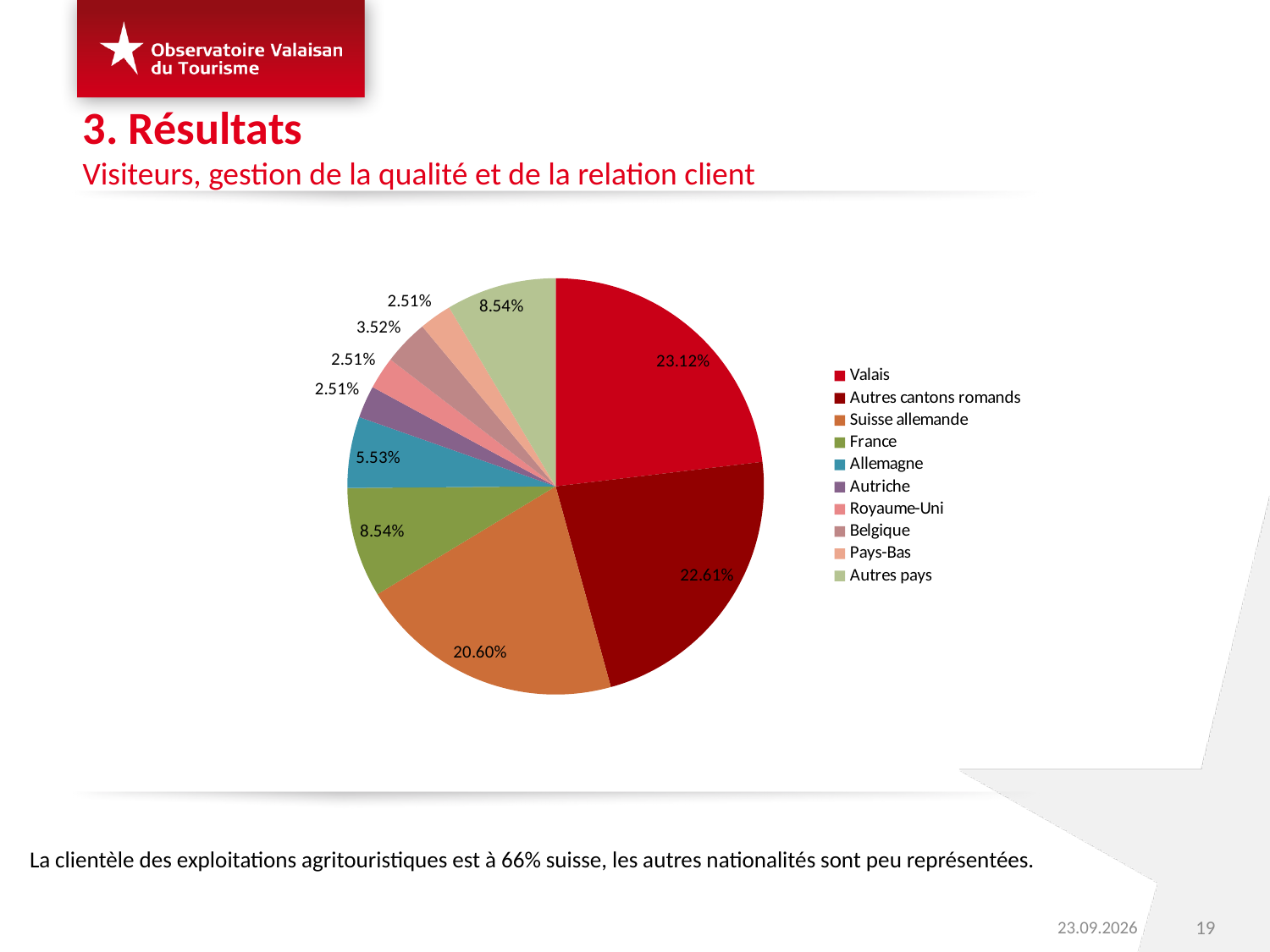
How many categories does the legend list? 10 Which is larger, the slice for France or the slice for Allemagne? France What percentage is shown for Belgique? 3.52% What is the difference between the Valais share and the Suisse allemande share? 2.52% Which category has the largest slice of the pie? Valais What is the difference between the France share and the Allemagne share? 3.01% What is the value for Allemagne? 5.53% What share of the pie does Valais represent? 23.12% What percentage is shown for Suisse allemande? 20.60% What kind of chart is shown on the slide? Pie chart Which legend entry is shown in blue? Allemagne What is the value for Autres cantons romands? 22.61%